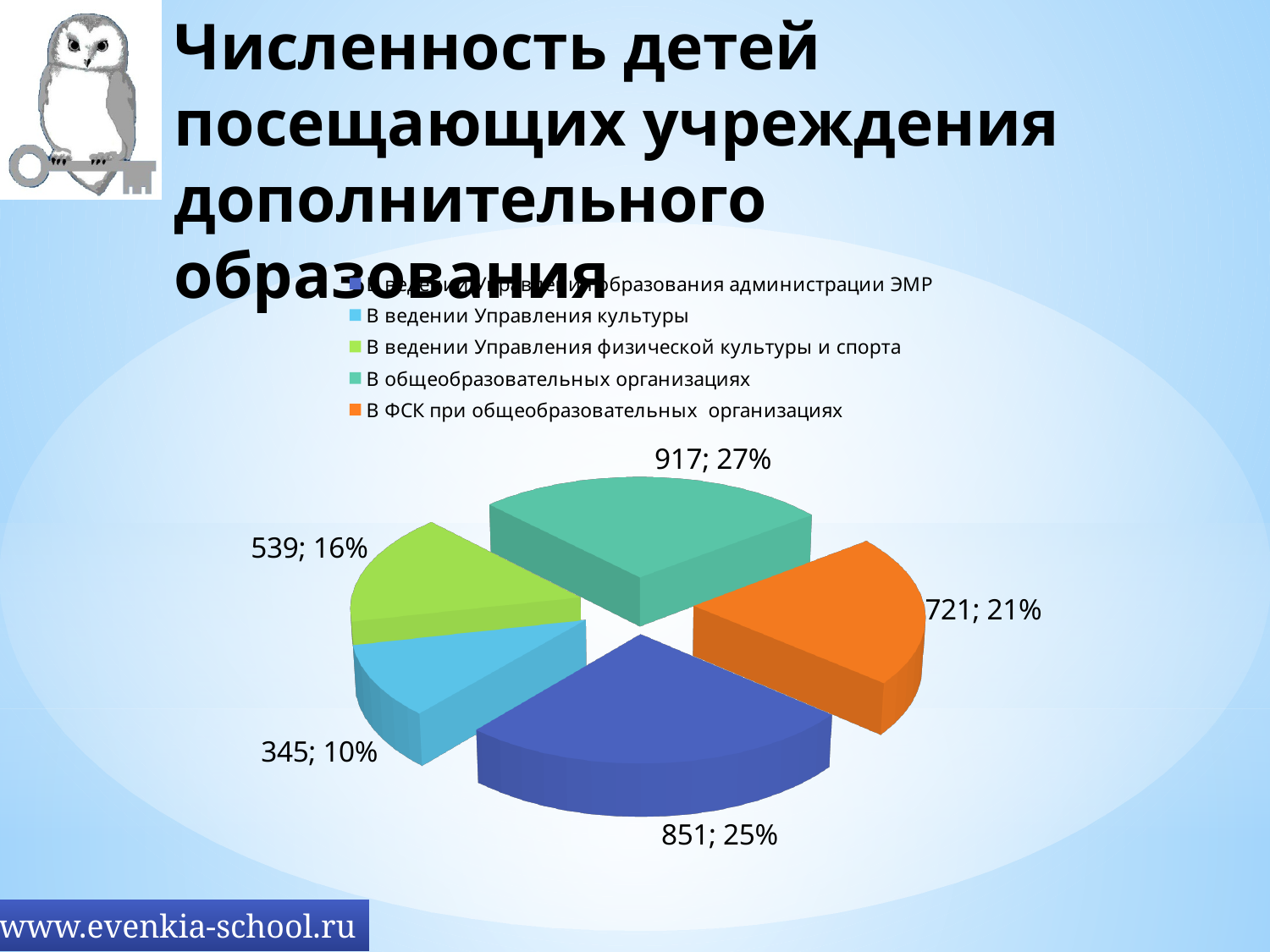
What colour is the slice for 'В ФСК при общеобразовательных организациях'? orange Which category has the largest slice? В общеобразовательных организациях What is the value for 'В общеобразовательных организациях'? 917 Which is larger: 'В ведении Управления физической культуры и спорта' or 'В ведении Управления культуры'? В ведении Управления физической культуры и спорта What is the value for 'В ведении Управления культуры'? 345 What is the difference between the values for 'В общеобразовательных организациях' and 'В ФСК при общеобразовательных организациях'? 196 Which category has the smallest slice? В ведении Управления культуры What share of the pie does 'В ФСК при общеобразовательных организациях' represent? 21% What kind of chart is shown on the slide? pie chart How many slices does the pie chart have? 5 What is the difference between the dark blue slice (851) and the green slice (539)? 312 What share of the pie does 'В ведении Управления физической культуры и спорта' represent? 16%